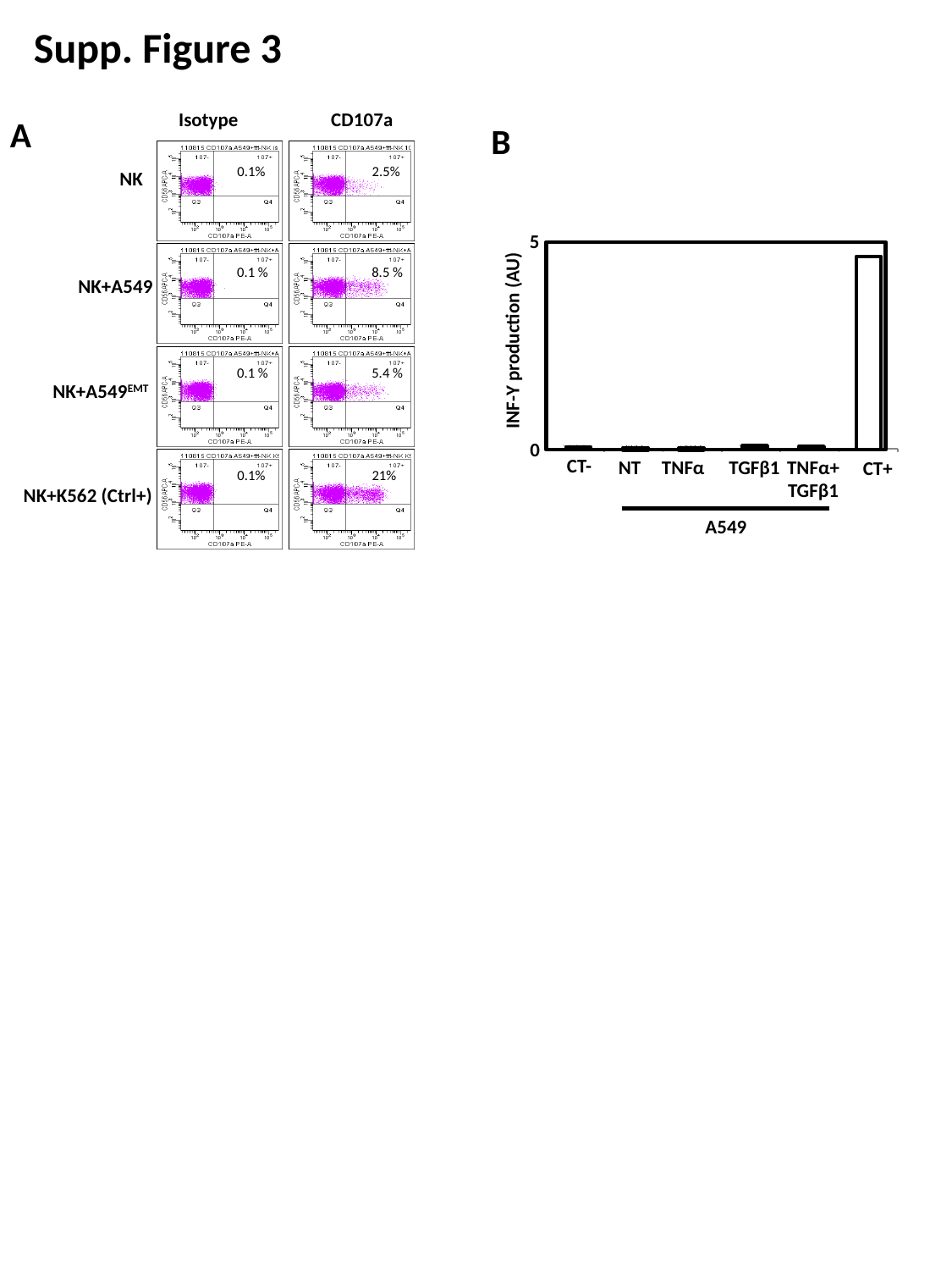
In panel B, what is the label of the y axis? INF-Y production (AU) In panel A, which condition has the highest CD107a percentage? NK+K562 (Ctrl+) In panel A, what is the difference between the CD107a percentage for NK+K562 (Ctrl+) and for NK alone? 18.5% In panel B, is the value for CT+ greater or less than 5? less In panel B, which category has the highest INF-Y production? CT+ In panel B, what kind of chart is shown? Bar chart In panel A, what percentage is shown in the CD107a plot for the NK condition alone? 2.5% In panel A, which CD107a percentage is larger: NK+A549 or NK+A549EMT? NK+A549 In panel A, what percentage is shown in the Isotype plot for the NK+A549EMT condition? 0.1 % In panel A, what percentage is shown in the CD107a plot for the NK+A549 condition? 8.5 % In panel A, what percentage is shown in the CD107a plot for the NK+K562 (Ctrl+) condition? 21% In panel B, how many categories are shown on the x axis? 6